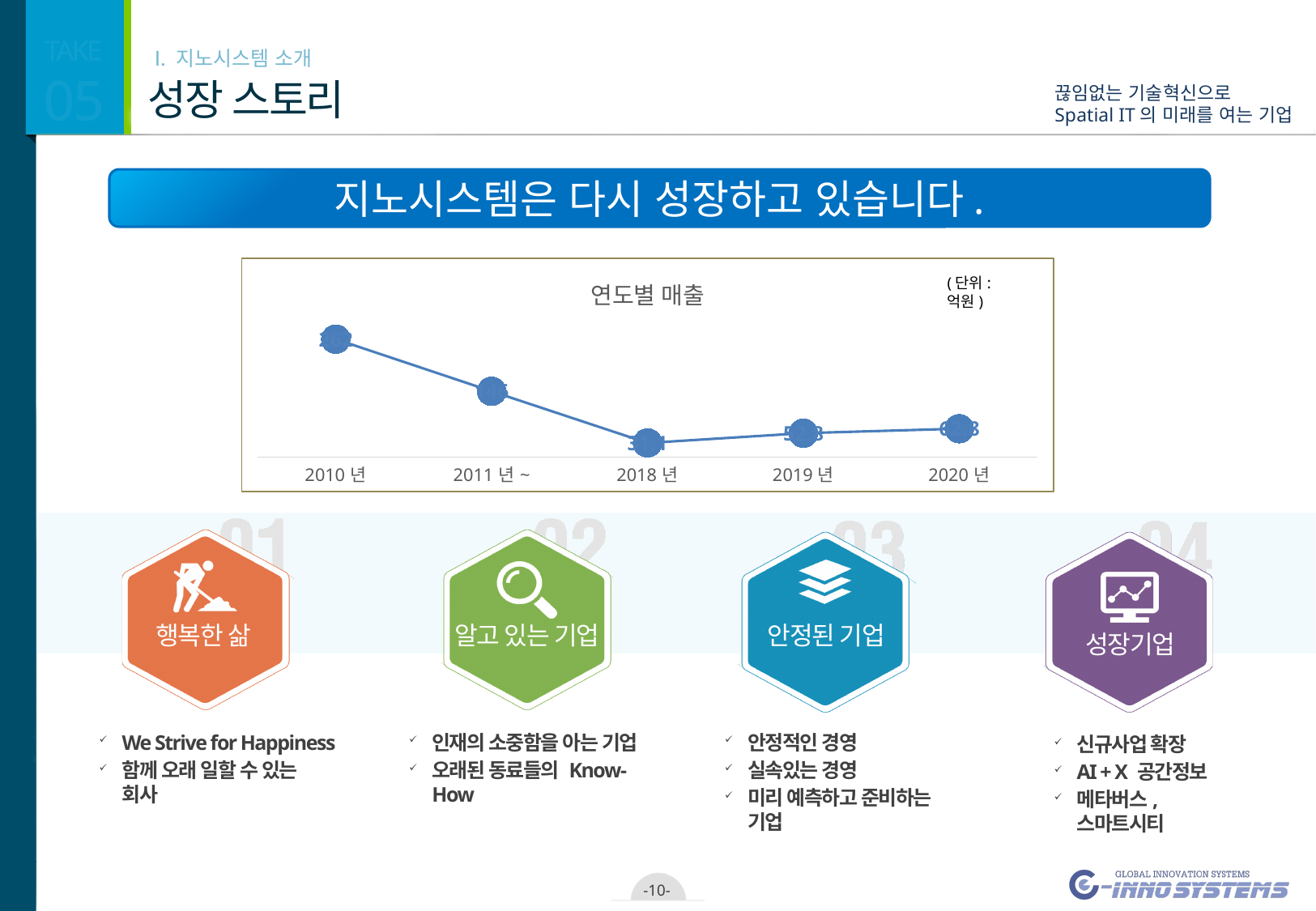
What is the first category on the x axis of the chart? 2010 년 What kind of chart is shown on the slide? line chart Do the values rise or fall from 2010 년 to 2018 년? fall What is the last category on the x axis of the chart? 2020 년 What unit is stated for the chart values? 억원 Which year has the highest value on the chart? 2010 년 Which year has the lowest value on the chart? 2018 년 Is the value for 2010 년 larger or smaller than the value for 2018 년? larger How many data points are plotted on the chart? 5 Which is larger, the value for 2011 년 ~ or the value for 2019 년? 2011 년 ~ Do the values rise or fall from 2018 년 to 2020 년? rise What is the title of the chart? 연도별 매출